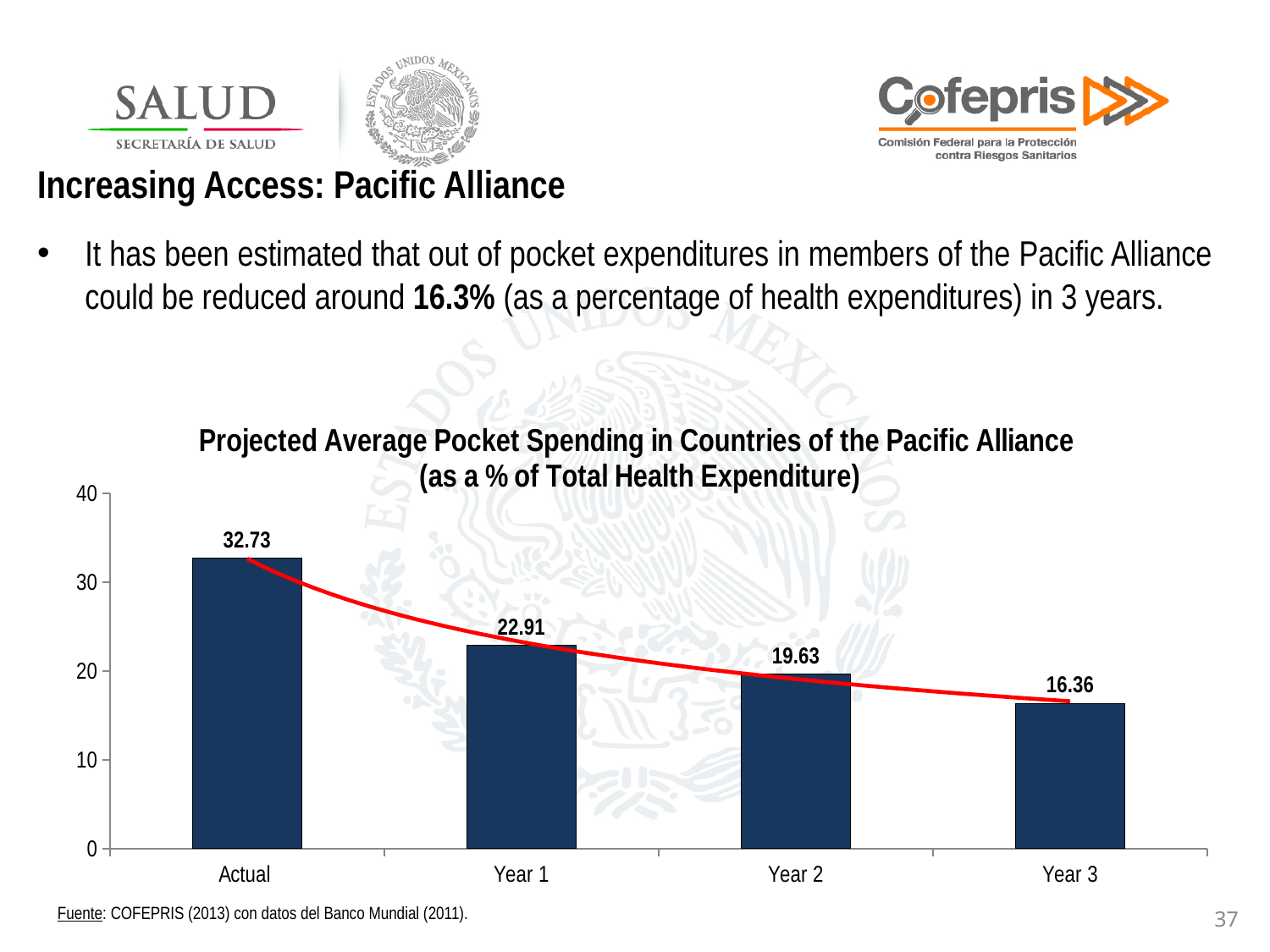
What is the projected average pocket spending value for Year 1? 22.91 What is the difference between the Actual value and the Year 3 value? 16.37 How many categories are shown on the x axis? 4 What is the difference between the Year 1 and Year 2 values? 3.28 What is the value shown for the Actual bar? 32.73 Which is larger, the value for Year 2 or the value for Year 3? Year 2 Is the value for Year 2 greater or less than 20? less What is the value shown for Year 3? 16.36 What kind of chart is shown on the slide? bar chart Which category has the highest value? Actual Which category has the lowest value? Year 3 Do the values rise or fall from Actual to Year 3? fall